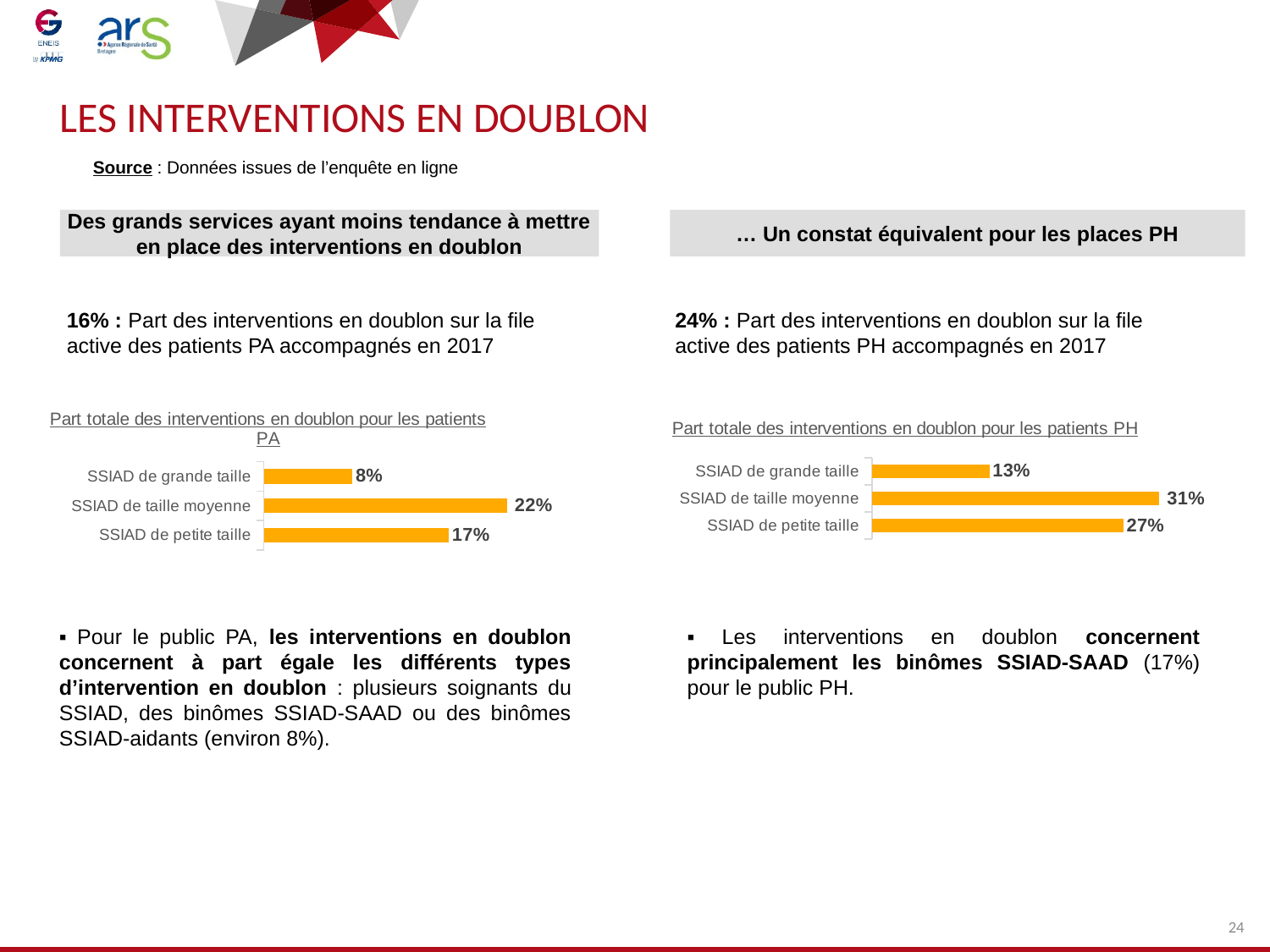
What colour are the bars in the chart 'Part totale des interventions en doublon pour les patients PA'? Orange In the chart 'Part totale des interventions en doublon pour les patients PH', which is larger: SSIAD de taille moyenne or SSIAD de grande taille? SSIAD de taille moyenne How many categories are shown in the chart 'Part totale des interventions en doublon pour les patients PA'? 3 In the chart 'Part totale des interventions en doublon pour les patients PA', what is the value for SSIAD de taille moyenne? 22% In the chart 'Part totale des interventions en doublon pour les patients PH', what is the difference between SSIAD de taille moyenne and SSIAD de petite taille? 4% In the chart 'Part totale des interventions en doublon pour les patients PA', what is the value for SSIAD de grande taille? 8% In the chart 'Part totale des interventions en doublon pour les patients PA', which category has the highest value? SSIAD de taille moyenne In the chart 'Part totale des interventions en doublon pour les patients PH', what is the value for SSIAD de petite taille? 27% In the chart 'Part totale des interventions en doublon pour les patients PH', which category has the lowest value? SSIAD de grande taille What kind of chart is 'Part totale des interventions en doublon pour les patients PH'? Bar chart In the chart 'Part totale des interventions en doublon pour les patients PA', what is the difference between SSIAD de taille moyenne and SSIAD de grande taille? 14% In the chart 'Part totale des interventions en doublon pour les patients PH', what is the value for SSIAD de grande taille? 13%